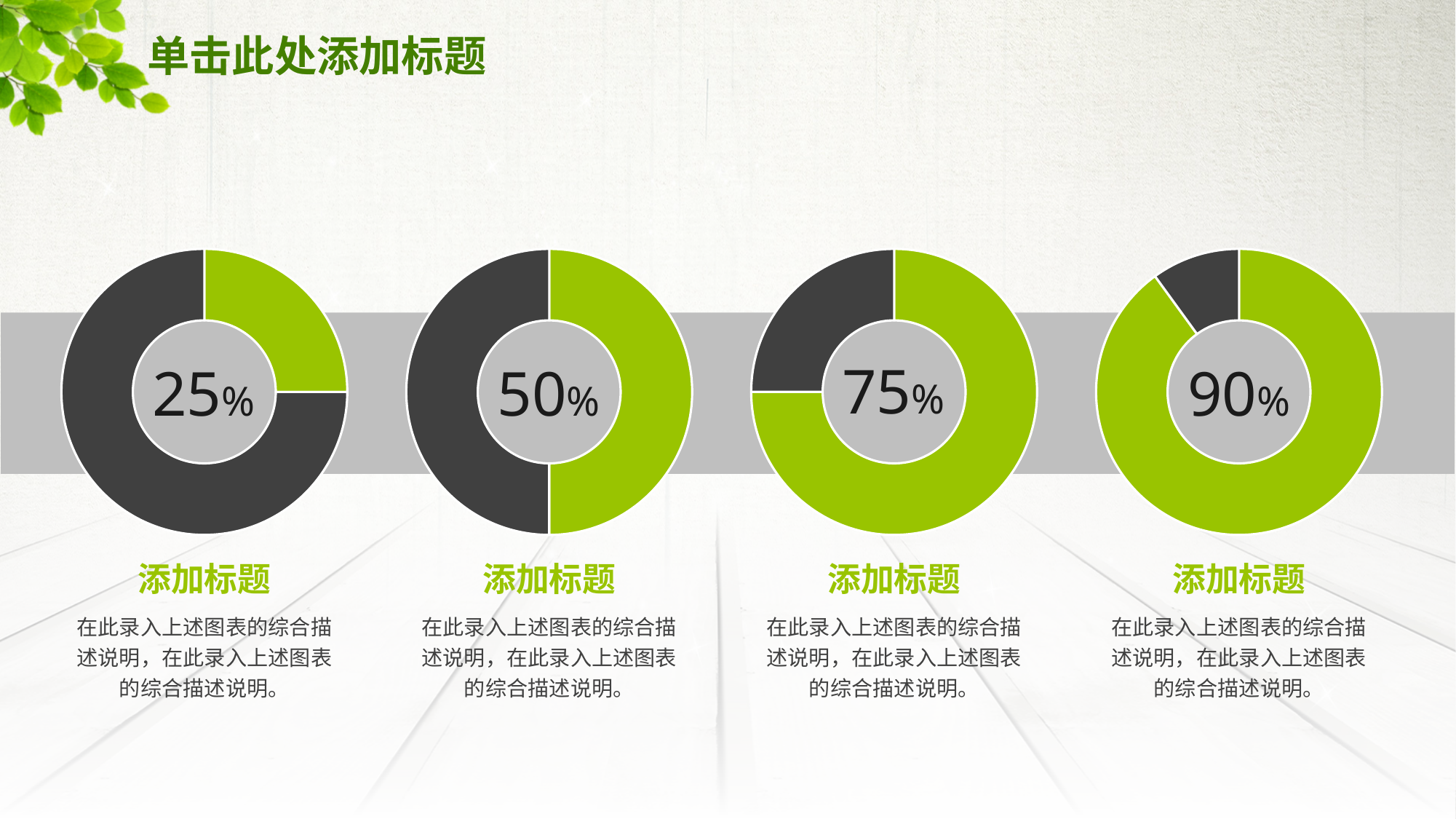
What percentage is shown in the centre of the third donut chart from the left? 75% What percentage is shown in the centre of the leftmost donut chart? 25% What percentage is shown in the centre of the second donut chart from the left? 50% How many donut charts are on the slide? 4 What percentage is shown in the centre of the rightmost donut chart? 90% Which is larger: the percentage in the second donut chart from the left or the percentage in the third donut chart from the left? The third chart (75%) Which donut chart shows the lowest percentage? The leftmost chart (25%) What colour is the filled (percentage) portion of each donut chart? Green Which donut chart shows the highest percentage? The rightmost chart (90%) Do the percentages in the donut charts increase or decrease from left to right across the slide? Increase What is the difference between the percentage in the rightmost donut chart and the percentage in the leftmost donut chart? 65% What kind of chart is each of the four charts on the slide? Donut chart